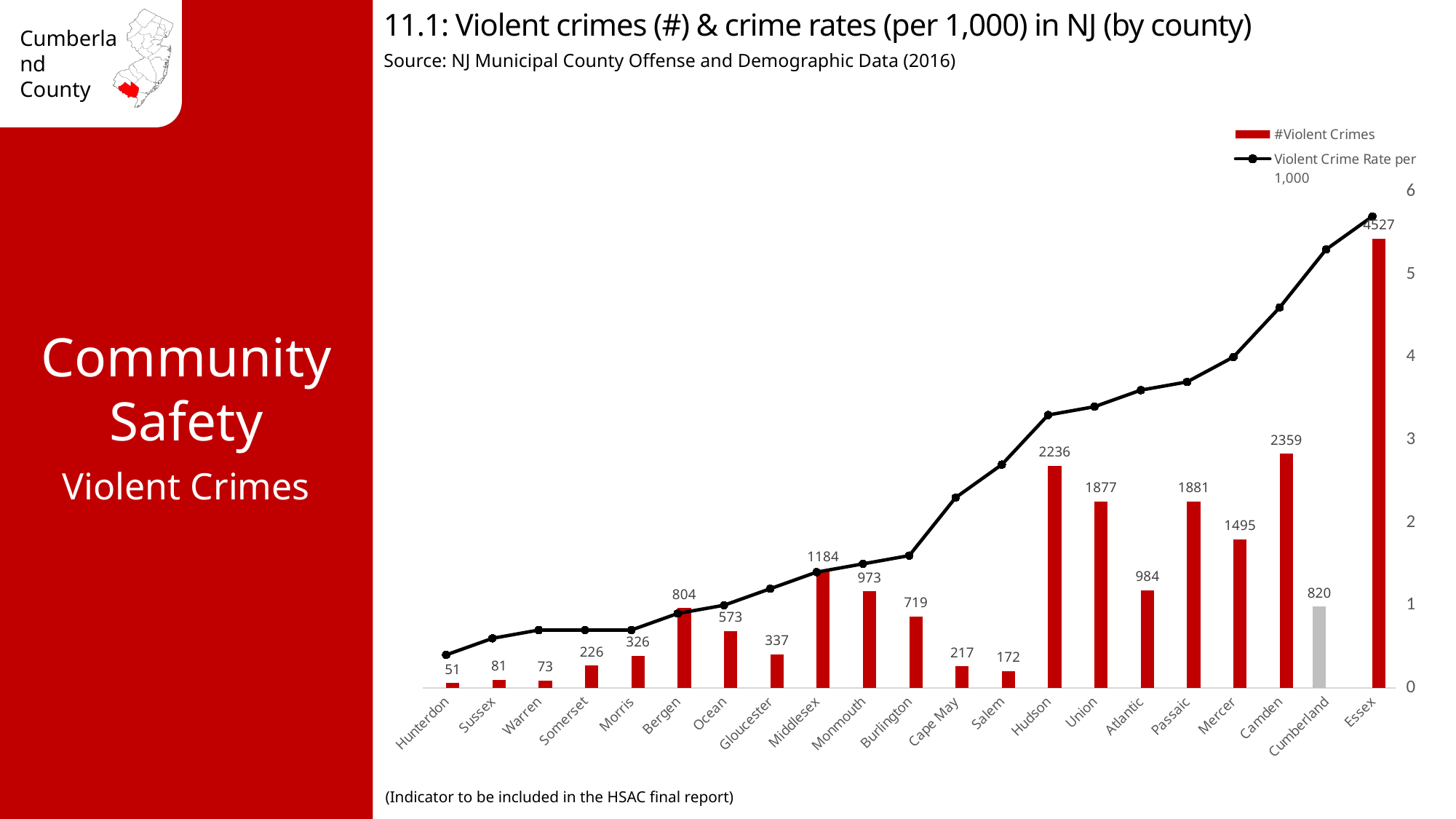
How many series does the legend list? 2 What is the difference in the number of violent crimes between Essex and Camden? 2168 Which county has the highest number of violent crimes? Essex Is the violent crime rate per 1,000 for Essex greater or less than 5? greater What is the number of violent crimes for Middlesex? 1184 Which county has the lowest number of violent crimes? Hunterdon Does the violent crime rate per 1,000 line generally rise or fall from left to right? rise What is the number of violent crimes for Cumberland? 820 What is the number of violent crimes for Hudson? 2236 Which has more violent crimes, Camden or Hudson? Camden Is the violent crime rate per 1,000 for Hunterdon greater or less than 1? less How many counties are shown on the x axis? 21